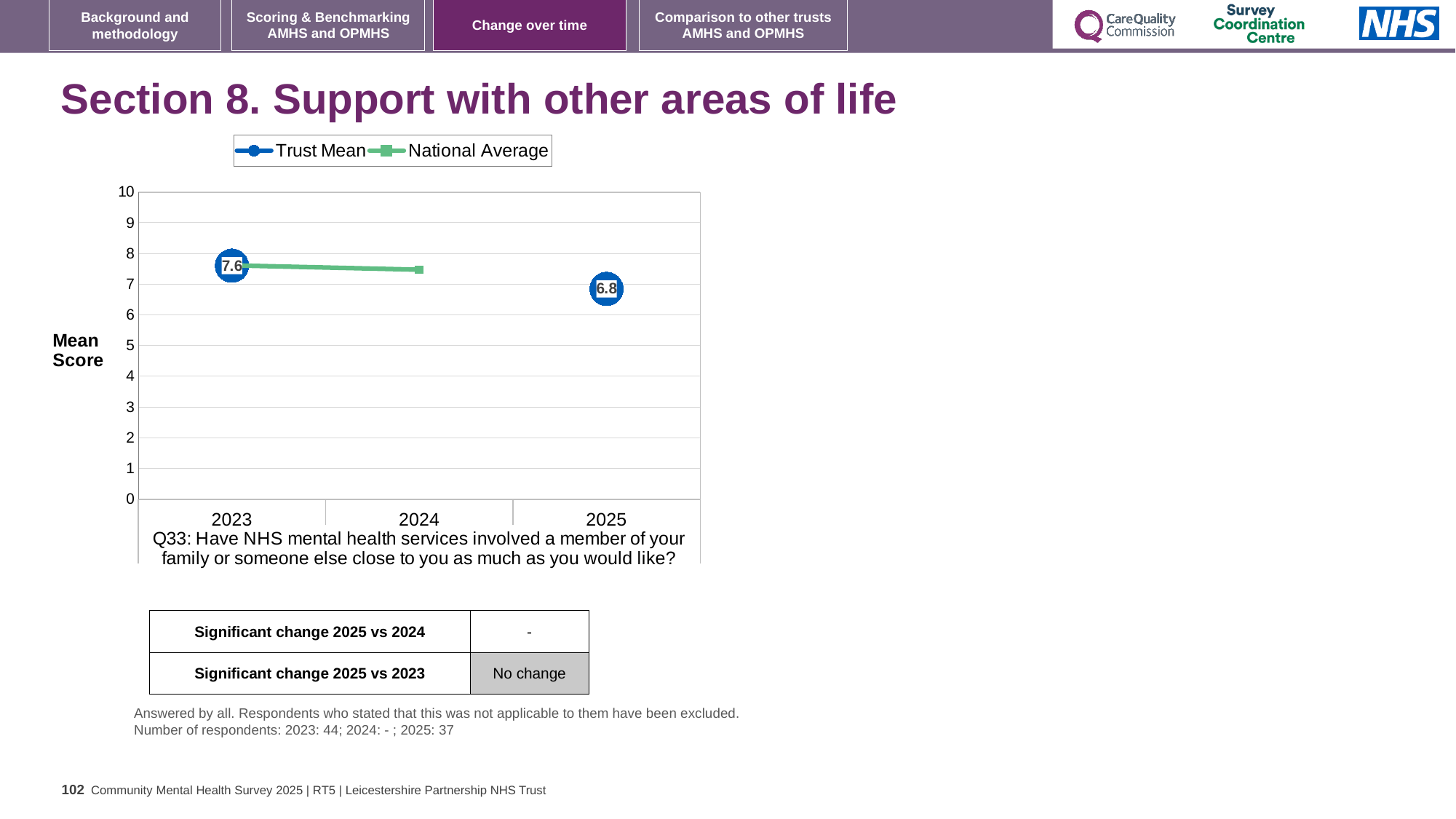
How many years are shown on the x axis of the chart? 3 Is the National Average value for 2023 greater or less than 8? less What is the label on the y axis of the chart? Mean Score In which year is the Trust Mean lowest? 2025 How many series does the chart legend list? 2 What kind of chart is shown on the slide? Line chart Does the Trust Mean rise or fall from 2023 to 2025? Fall What is the Trust Mean value for 2025? 6.8 What is the Trust Mean value for 2023? 7.6 What is the difference between the Trust Mean in 2023 and the Trust Mean in 2025? 0.8 Which year has the higher Trust Mean, 2023 or 2025? 2023 Is the National Average value for 2024 greater or less than 7? greater